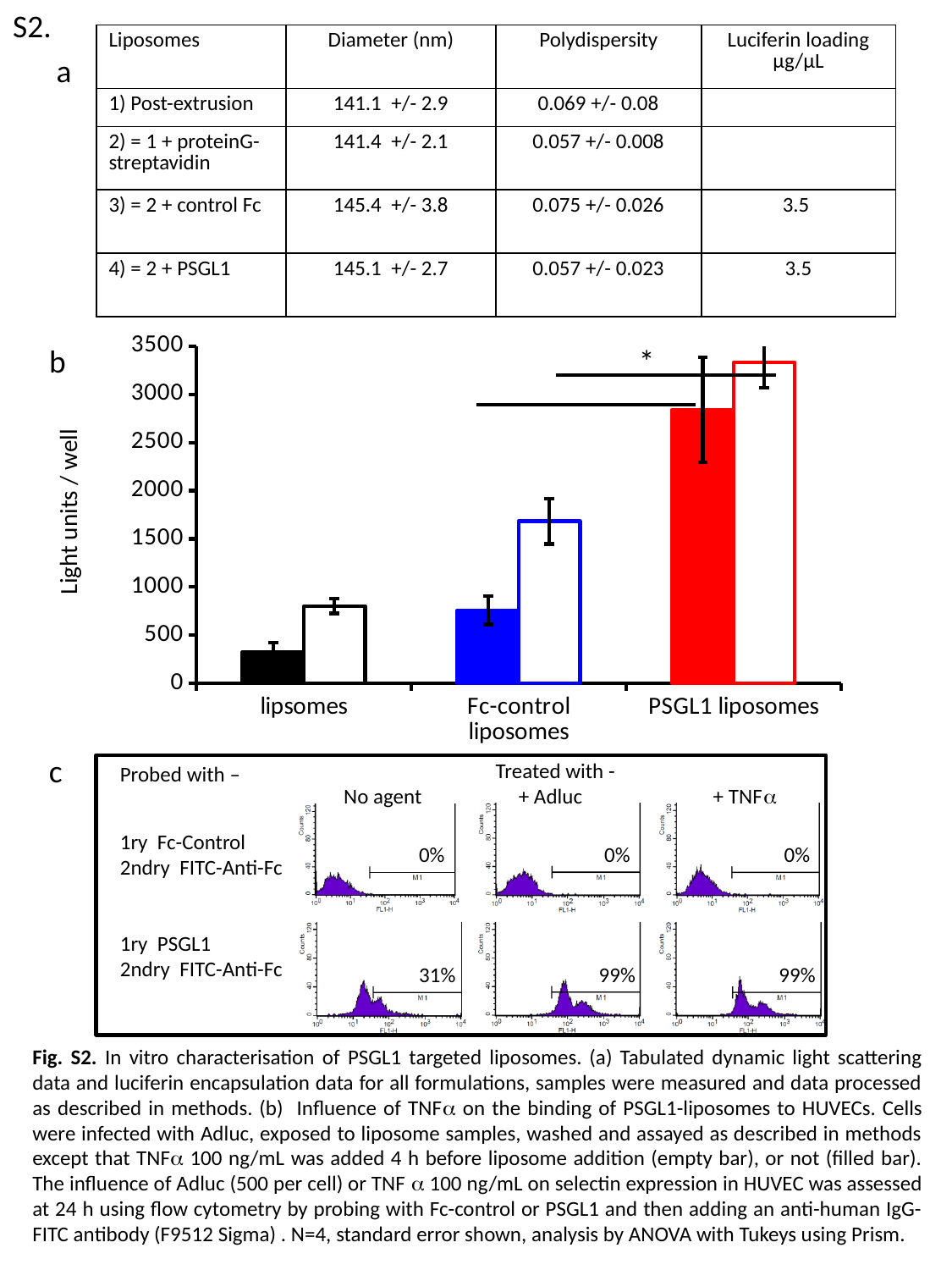
In the bar chart in panel b, how many liposome categories are shown on the x axis? 3 In the bar chart in panel b, is the value of the filled bar for lipsomes greater or less than 500? less What is the y-axis label of the bar chart in panel b? Light units / well In the bar chart in panel b, which category has the lowest light units / well? lipsomes In the bar chart in panel b, is the value of the empty bar for PSGL1 liposomes greater or less than 3000? greater In the bar chart in panel b, do the values rise or fall from lipsomes to PSGL1 liposomes along the x axis? rise In the bar chart in panel b, is the value of the filled bar for PSGL1 liposomes greater or less than 2500? greater In the bar chart in panel b, for Fc-control liposomes, which is larger: the filled bar or the empty bar? the empty bar What kind of chart is panel b? bar chart In the bar chart in panel b, which category has the highest light units / well? PSGL1 liposomes In panel c, what percentage is shown for cells probed with PSGL1 and treated with + Adluc? 99%